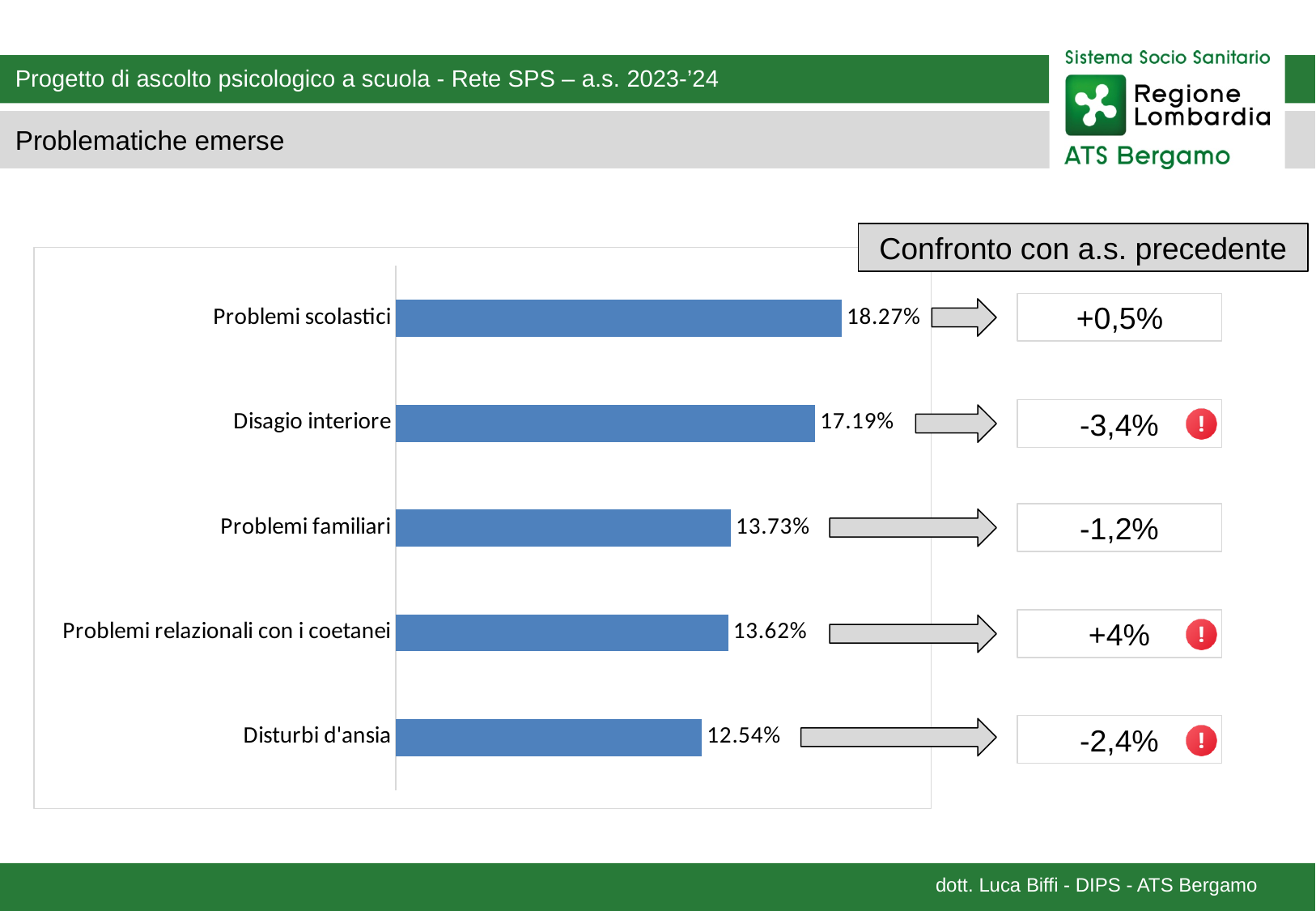
What is the value for Disturbi d'ansia? 12.54% What is the value for Disagio interiore? 17.19% What is the difference between the values for Problemi scolastici and Disturbi d'ansia? 5.73 percentage points What is the value for Problemi familiari? 13.73% According to the comparison with the previous school year shown next to the chart, what is the change for Problemi relazionali con i coetanei? +4% What kind of chart is shown on the slide? Bar chart What is the value for Problemi relazionali con i coetanei? 13.62% Which is larger, the value for Problemi scolastici or the value for Disagio interiore? Problemi scolastici Which category has the lowest value? Disturbi d'ansia What is the value for Problemi scolastici? 18.27% How many categories are shown in the chart? 5 Which category has the highest value? Problemi scolastici